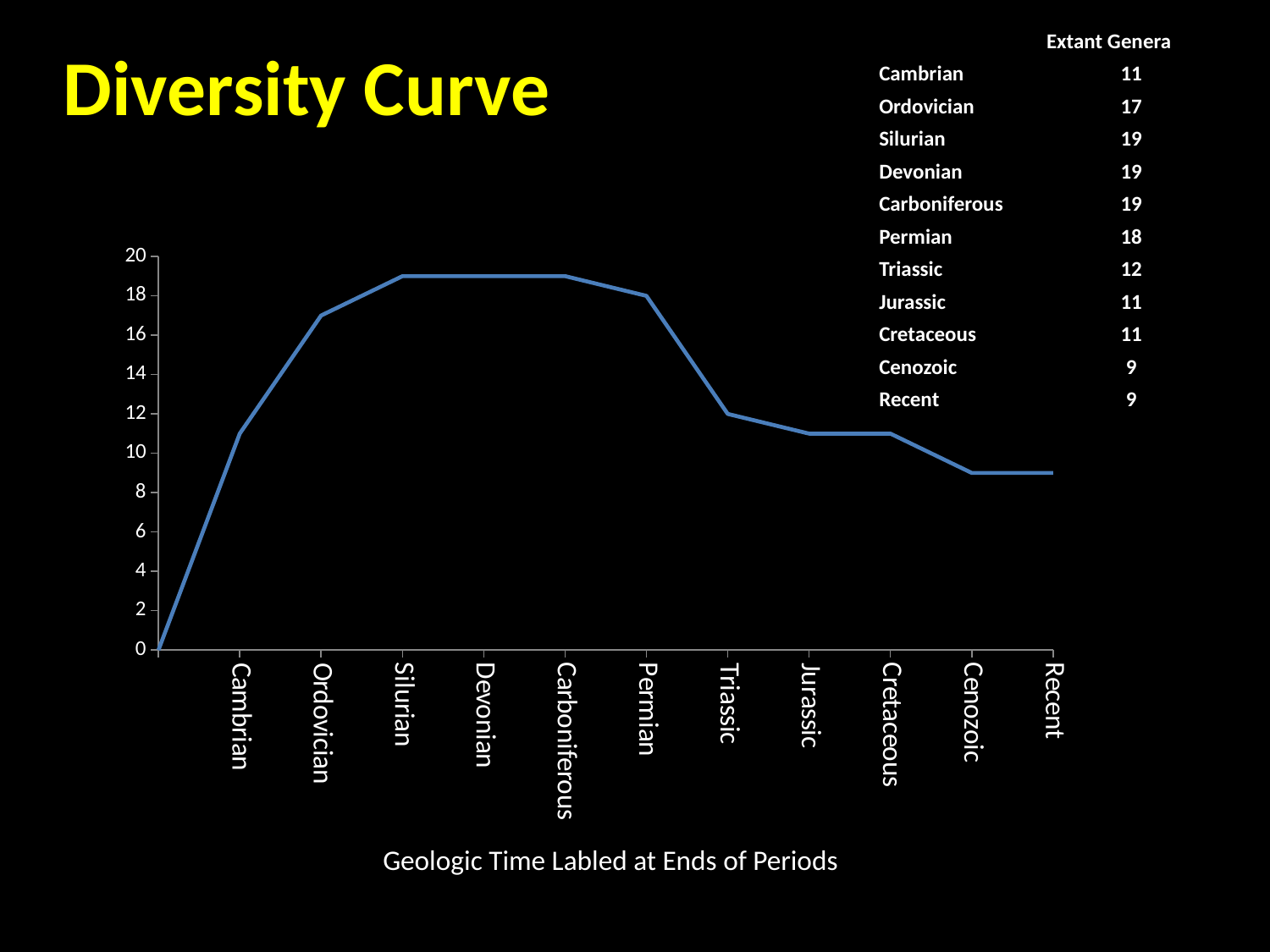
What is the value for Ordovician? 17 Which is larger, the value for Ordovician or the value for Jurassic? Ordovician What kind of chart is shown on the slide? line chart Which labeled period has the lowest value? Cenozoic and Recent What is the difference between the Silurian value and the Triassic value? 7 Is the value for Cambrian greater or less than 10? greater What is the value for Triassic? 12 What is the value for Permian? 18 How many labeled periods are on the x axis? 11 What is the value for Recent? 9 Do the values rise or fall from Permian to Recent? fall What is the title of the slide? Diversity Curve